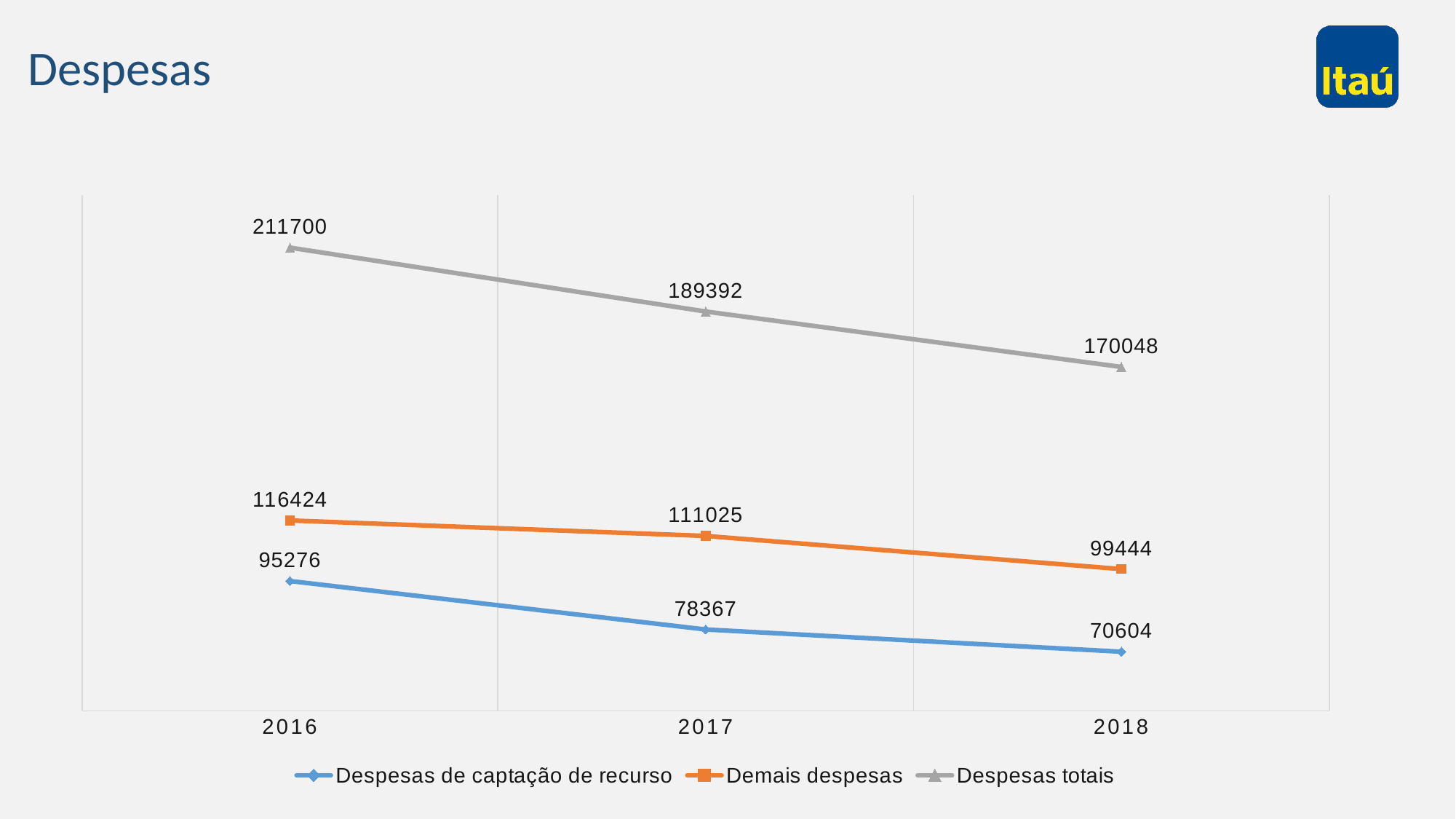
What is the value of Despesas totais in 2016? 211700 What is the value of Despesas de captação de recurso in 2018? 70604 What is the difference between Despesas totais in 2016 and 2018? 41652 In which year is Despesas de captação de recurso lowest? 2018 What is the value of Demais despesas in 2017? 111025 How many series does the legend list? 3 In which year is Despesas totais highest? 2016 Which is larger in 2018: Demais despesas or Despesas de captação de recurso? Demais despesas Do the values of Demais despesas rise or fall from 2016 to 2018? Fall What kind of chart is shown on the slide? Line chart What is the difference between Demais despesas and Despesas de captação de recurso in 2017? 32658 How many years are shown on the x axis? 3